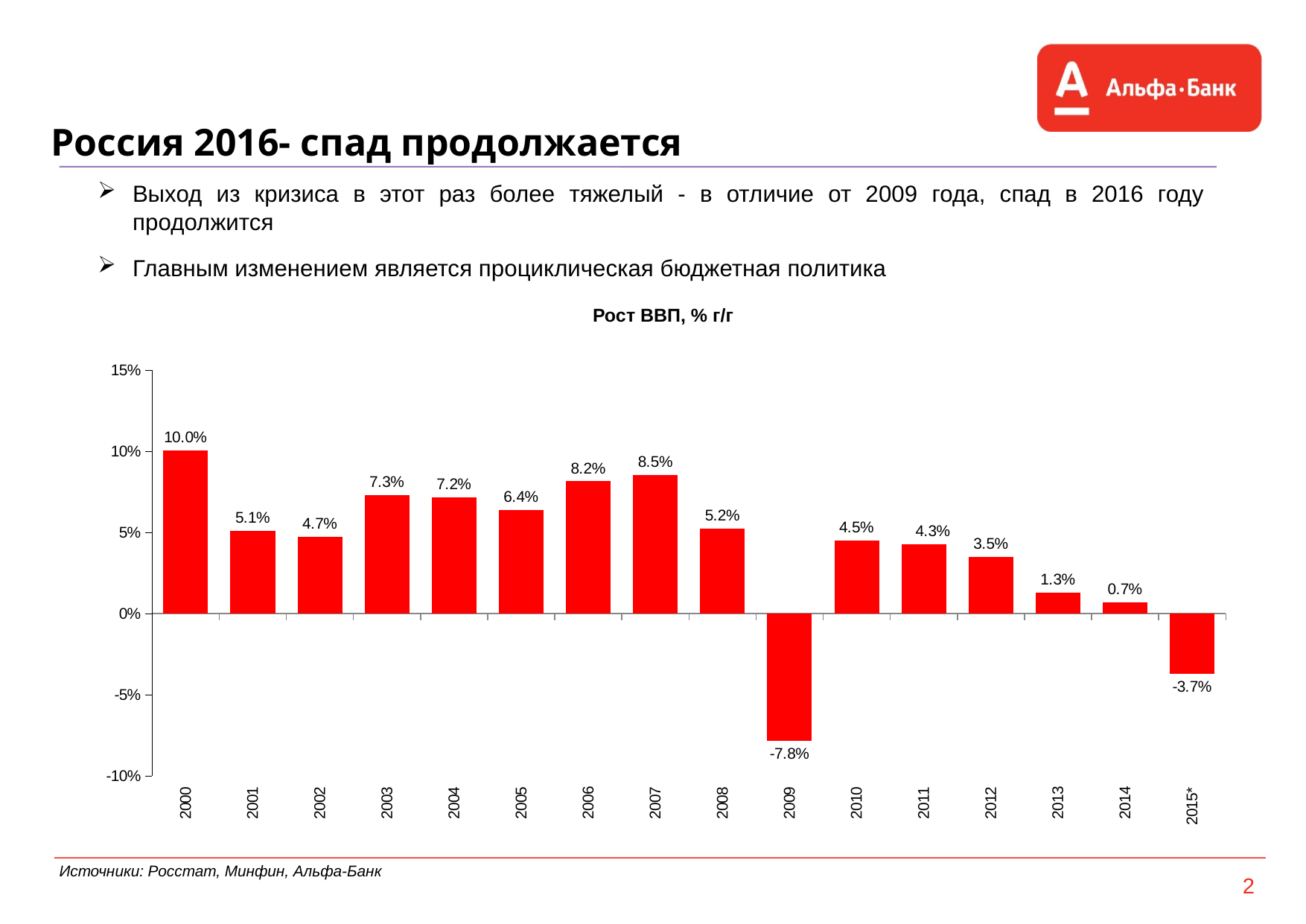
Do the GDP growth values rise or fall from 2010 to 2014? Fall What is the GDP growth value shown for 2015*? -3.7% What kind of chart is used to show GDP growth? Bar chart Which year has the lowest GDP growth in the chart? 2009 What is the GDP growth value shown for 2009? -7.8% What is the GDP growth value shown for 2000? 10.0% What is the GDP growth value shown for 2013? 1.3% Which year has the larger GDP growth value, 2003 or 2012? 2003 How many years are shown on the x axis of the chart? 16 What is the difference between the GDP growth values for 2007 and 2008? 3.3% What is the title of the chart? Рост ВВП, % г/г Which year has the highest GDP growth in the chart? 2000